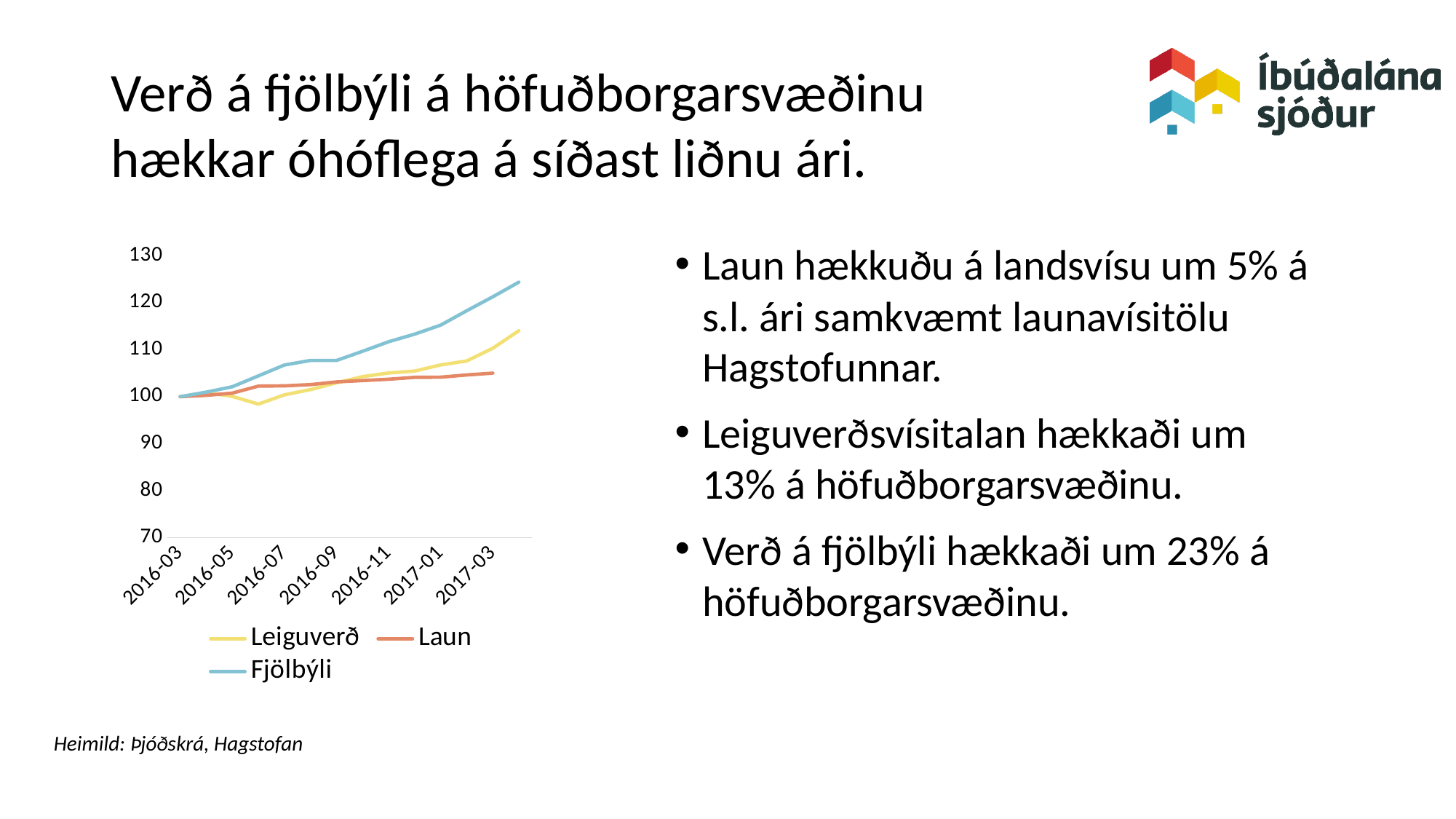
Is the value for Laun at 2017-03 greater or less than 110? less Is the value for Fjölbýli at 2017-03 greater or less than 120? greater How many date labels are shown on the x axis? 7 Which series has the highest value at 2017-03? Fjölbýli What kind of chart is shown on the slide? line chart Which series has the lowest value at 2017-03? Laun Does the Fjölbýli line rise or fall from 2016-03 to 2017-03? rise What are the three series named in the chart legend? Leiguverð, Laun, Fjölbýli How many series does the chart legend list? 3 At 2017-03, which is higher: Fjölbýli or Leiguverð? Fjölbýli What value do all three series start at in 2016-03? 100